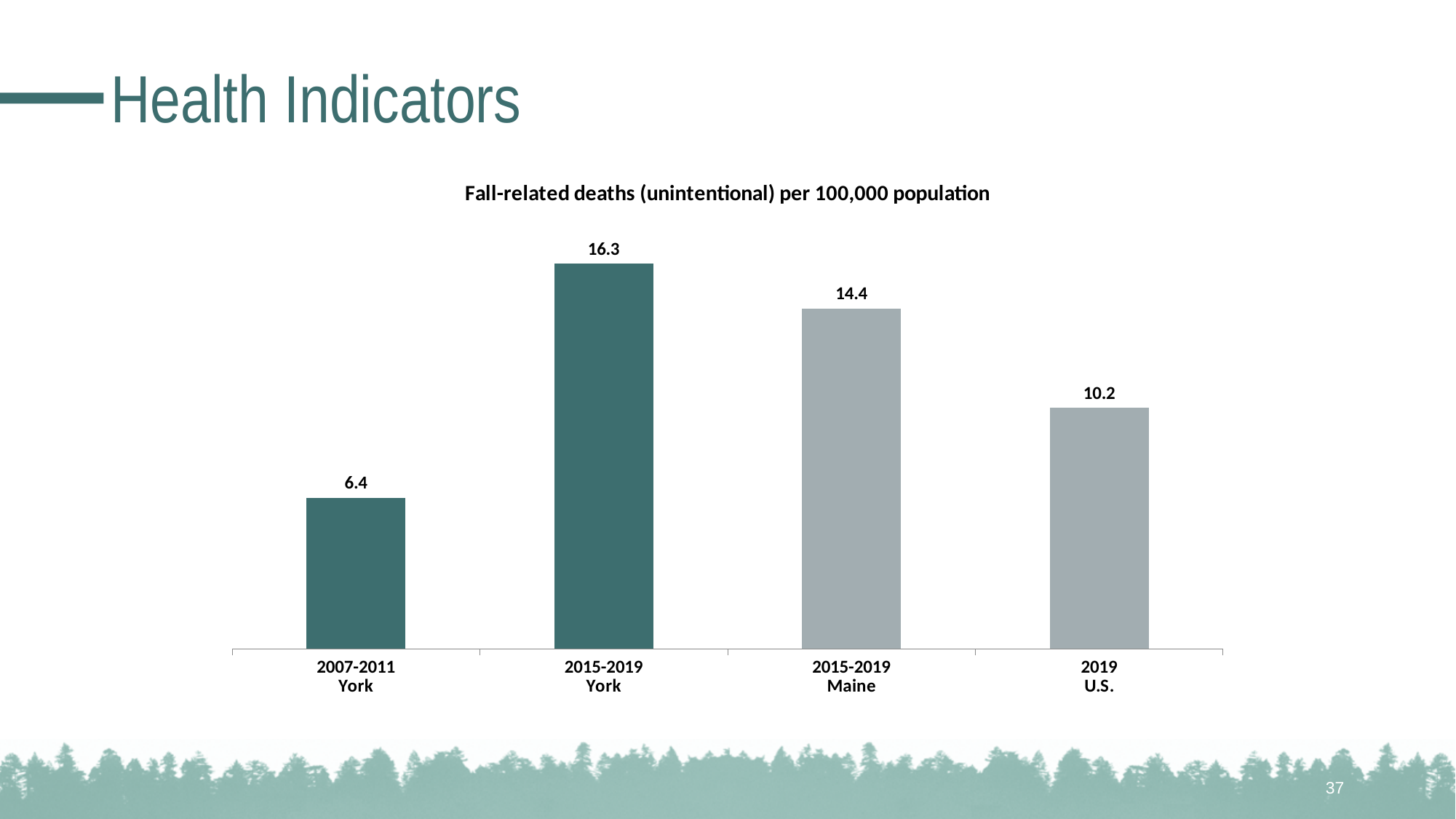
Which category has the highest value? 2015-2019 York Which category has the lowest value? 2007-2011 York What is the difference between the 2015-2019 York value and the 2015-2019 Maine value? 1.9 How many bars are shown in the chart? 4 What is the value for 2019 U.S.? 10.2 What is the value for 2015-2019 Maine? 14.4 What is the value for 2007-2011 York? 6.4 What is the title of the chart? Fall-related deaths (unintentional) per 100,000 population What is the difference between the 2015-2019 York value and the 2007-2011 York value? 9.9 What kind of chart is shown on the slide? Bar chart Which is larger, the value for 2015-2019 Maine or the value for 2019 U.S.? 2015-2019 Maine What is the value for 2015-2019 York? 16.3